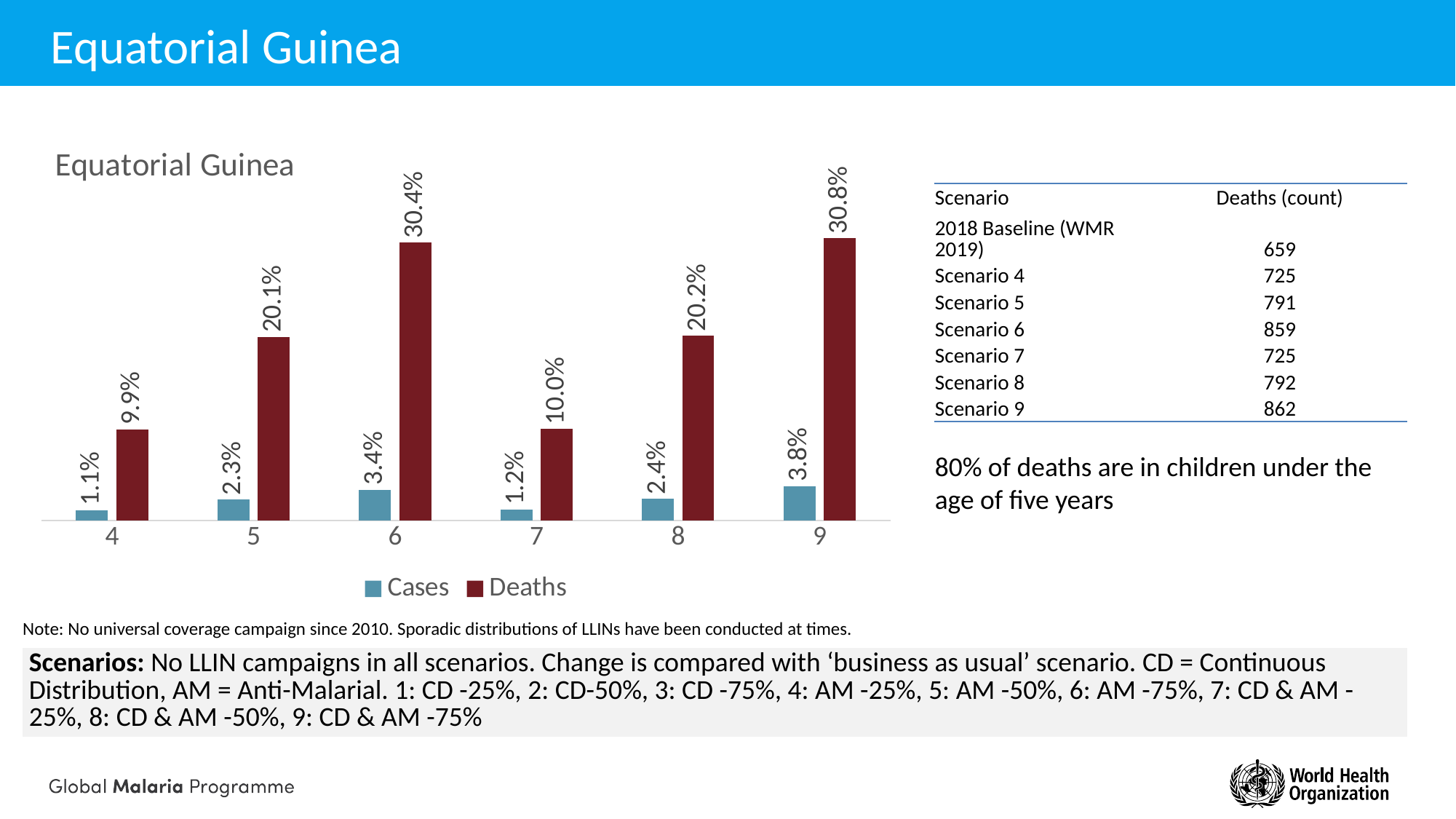
What is the difference between the Cases values for scenarios 6 and 5? 1.1% Which is larger, the Deaths value for scenario 5 or for scenario 8? Scenario 8 What is the title of the chart? Equatorial Guinea What is the Deaths value for scenario 6? 30.4% How many series does the chart legend list? 2 What is the Cases value for scenario 9? 3.8% How many scenarios are shown on the x axis of the chart? 6 What is the difference between the Deaths values for scenarios 9 and 6? 0.4% Which scenario has the highest Deaths value? 9 Which scenario has the lowest Cases value? 4 What is the Cases value for scenario 4? 1.1% What kind of chart is shown on the slide? Bar chart